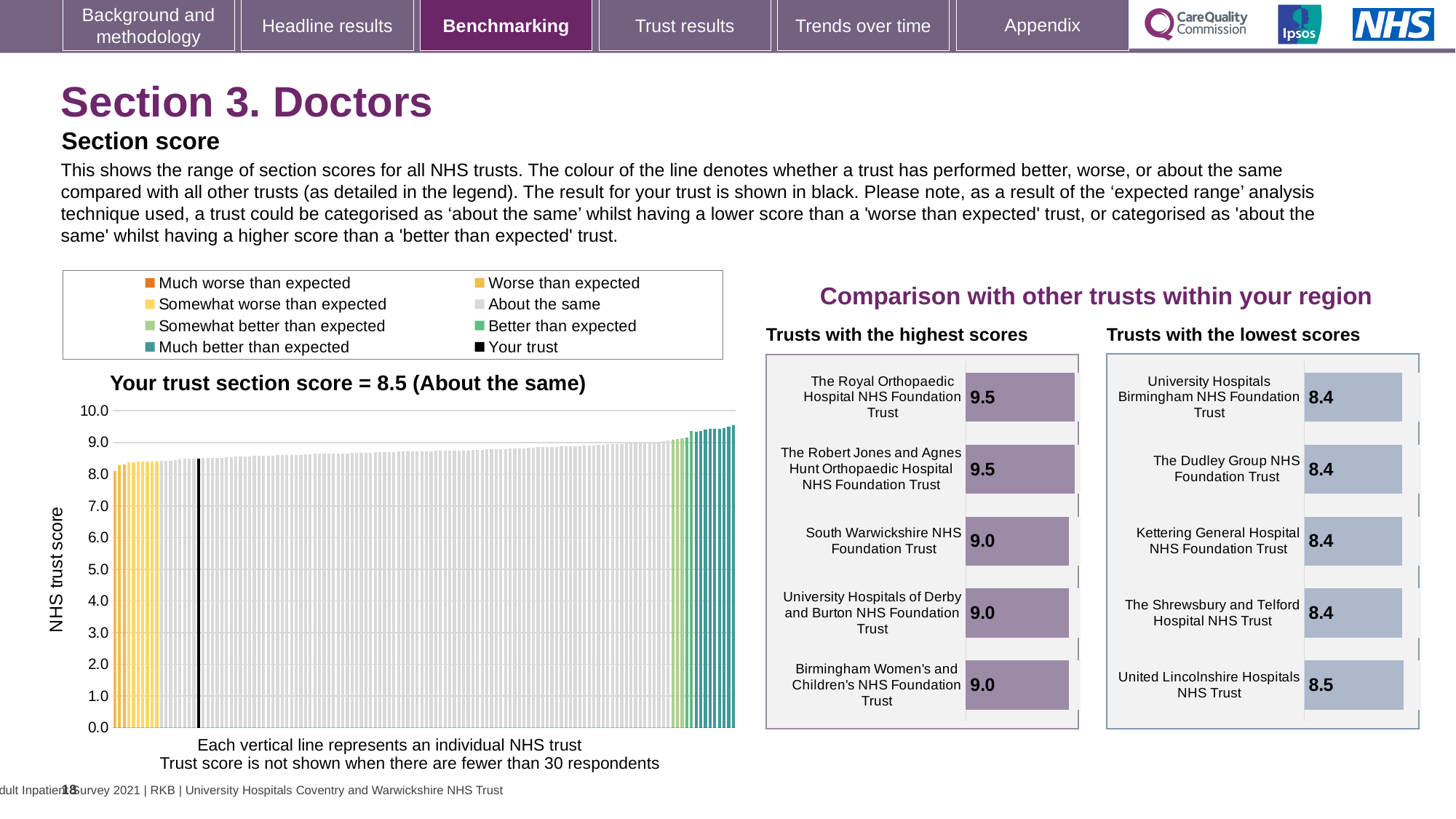
How many entries does the legend above the 'Your trust section score' chart list? 8 In the 'Your trust section score' chart, what is the trust's section score? 8.5 What kind of chart is the 'Your trust section score' chart? bar chart In the 'Trusts with the highest scores' chart, what is the difference between the scores of The Royal Orthopaedic Hospital NHS Foundation Trust and South Warwickshire NHS Foundation Trust? 0.5 In the 'Trusts with the highest scores' chart, which has the higher score: The Robert Jones and Agnes Hunt Orthopaedic Hospital NHS Foundation Trust or Birmingham Women's and Children's NHS Foundation Trust? The Robert Jones and Agnes Hunt Orthopaedic Hospital NHS Foundation Trust In the 'Your trust section score' chart, do the bars rise or fall from left to right along the x axis? rise In the 'Trusts with the highest scores' chart, how many trusts are shown? 5 In the 'Trusts with the lowest scores' chart, what is the score for Kettering General Hospital NHS Foundation Trust? 8.4 What is the y-axis label of the 'Your trust section score' chart? NHS trust score In the 'Trusts with the lowest scores' chart, which trust has the highest score? United Lincolnshire Hospitals NHS Trust In the 'Trusts with the highest scores' chart, what is the score for The Royal Orthopaedic Hospital NHS Foundation Trust? 9.5 In the 'Your trust section score' chart, which category is the trust's score placed in? About the same